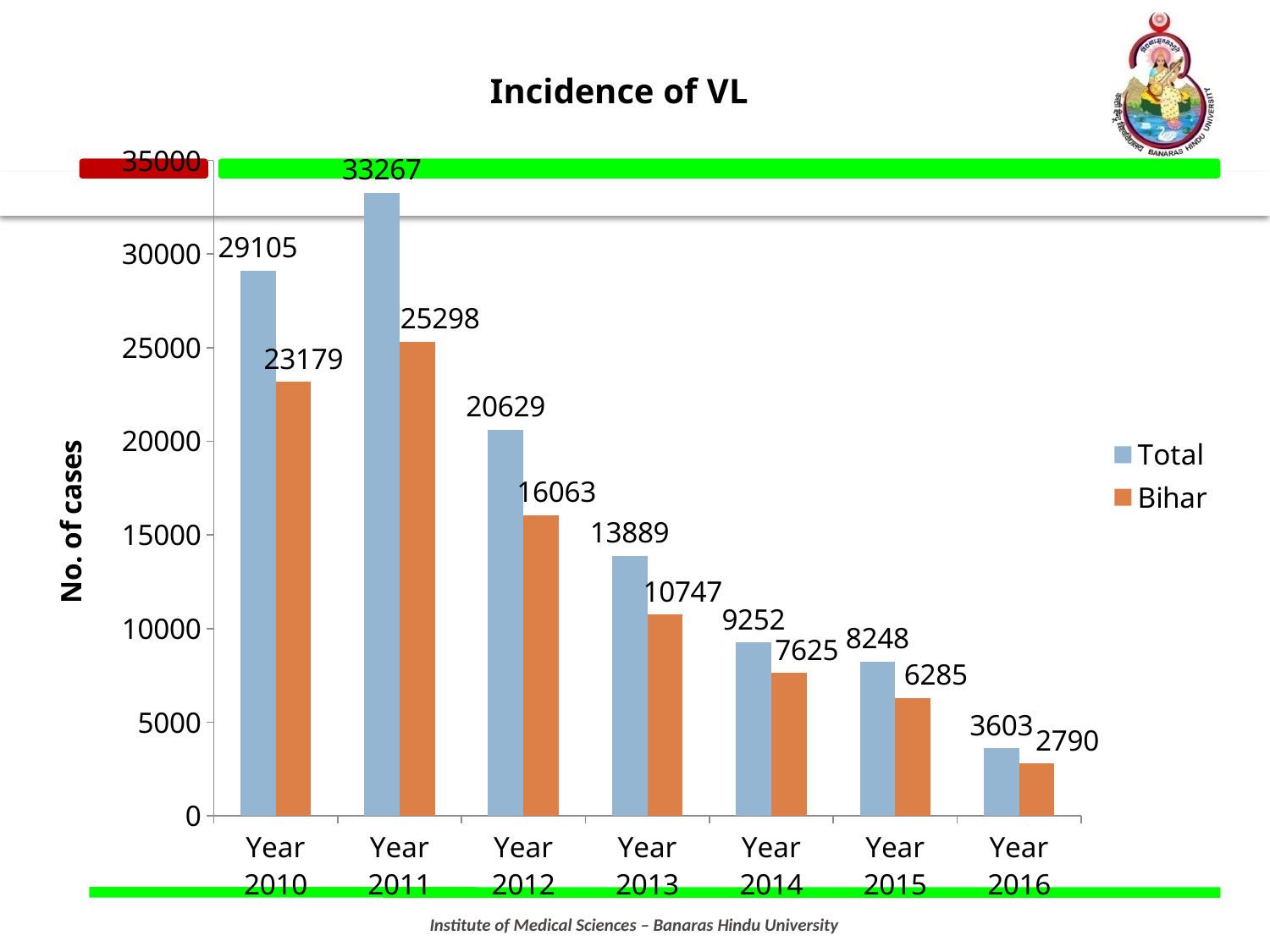
What is the difference between the Total and Bihar values for Year 2010? 5926 What kind of chart is shown? bar chart What is the Bihar value for Year 2013? 10747 What is the Total value for Year 2016? 3603 How many years are shown on the x axis? 7 Which is larger, the Bihar value for Year 2012 or the Total value for Year 2013? Bihar value for Year 2012 What is the Total value for Year 2011? 33267 How many series does the legend list? 2 Which year has the highest Total value? Year 2011 Which year has the lowest Bihar value? Year 2016 Do the Total values rise or fall from Year 2011 to Year 2016? fall Is the Total value for Year 2014 greater or less than 10000? less